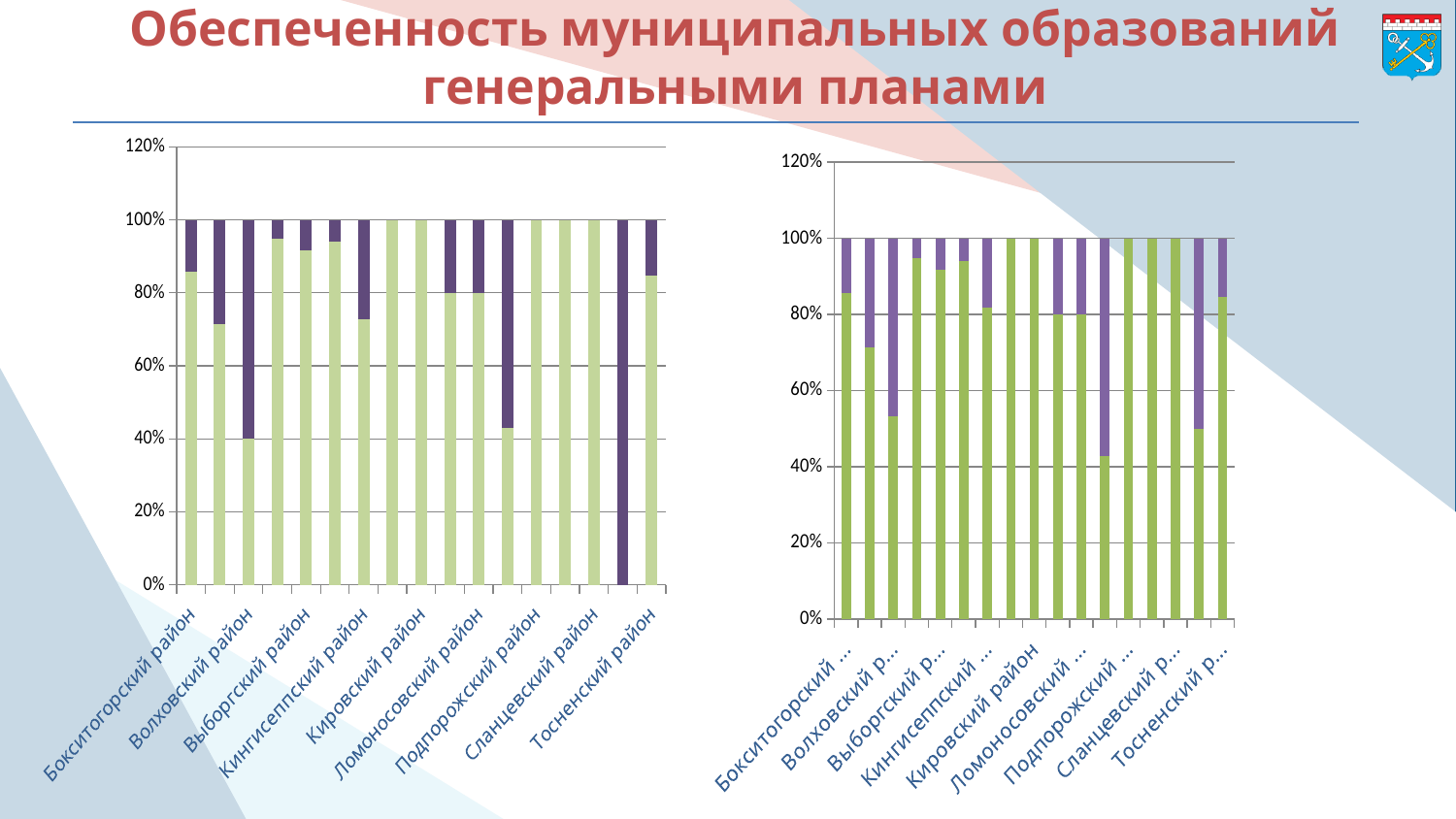
On the left chart, how many category labels are readable on the x axis? 9 What is the title of the slide containing the two charts? Обеспеченность муниципальных образований генеральными планами On the right chart, what is the total height of the stacked bar for Тосненский район? 100% On the left chart, what is the highest value shown on the vertical axis? 120% What kind of chart is shown on the right side of the slide? stacked bar chart On the left chart, what is the last category label on the x axis? Тосненский район On the left chart, what is the first category label on the x axis? Бокситогорский район On the left chart, is the green portion of the bar for Бокситогорский район greater or less than 80%? greater What kind of chart is shown on the left side of the slide? stacked bar chart On the left chart, what is the total height of the stacked bar for Бокситогорский район? 100% On the right chart, what is the lowest value shown on the vertical axis? 0% On the right chart, is the green portion of the bar for Тосненский район greater or less than 80%? greater